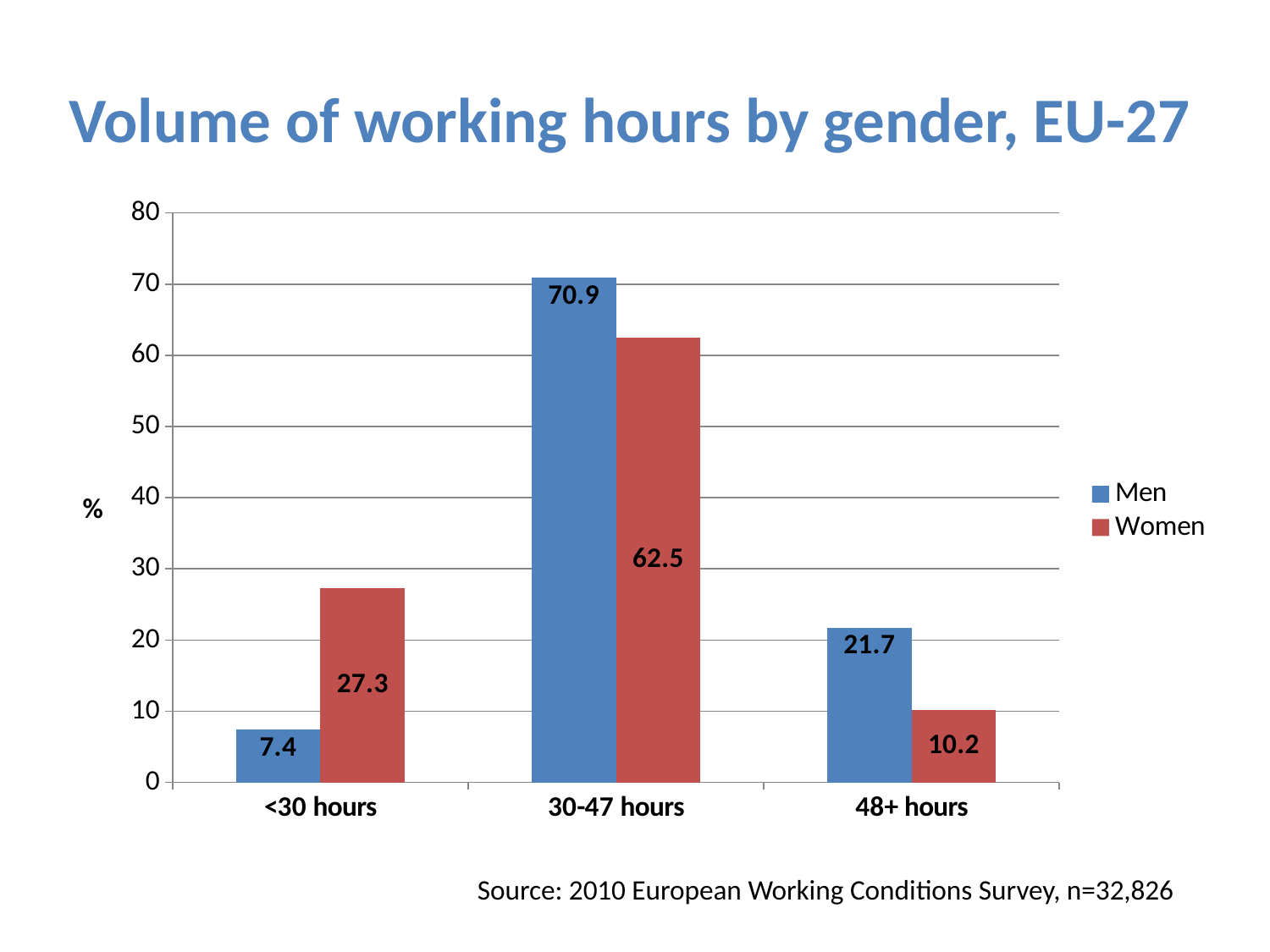
How many series does the legend list? 2 What is the value for Men in the 48+ hours category? 21.7 What is the value for Men in the <30 hours category? 7.4 Which is larger in the <30 hours category, Men or Women? Women What is the value for Women in the <30 hours category? 27.3 Which category has the lowest value for Women? 48+ hours What kind of chart is shown on the slide? bar chart What is the value for Women in the 30-47 hours category? 62.5 Is the value for Women in the 48+ hours category greater or less than 20? less Which category has the highest value for Men? 30-47 hours How many categories are shown on the x axis? 3 What is the difference between Men and Women in the 30-47 hours category? 8.4